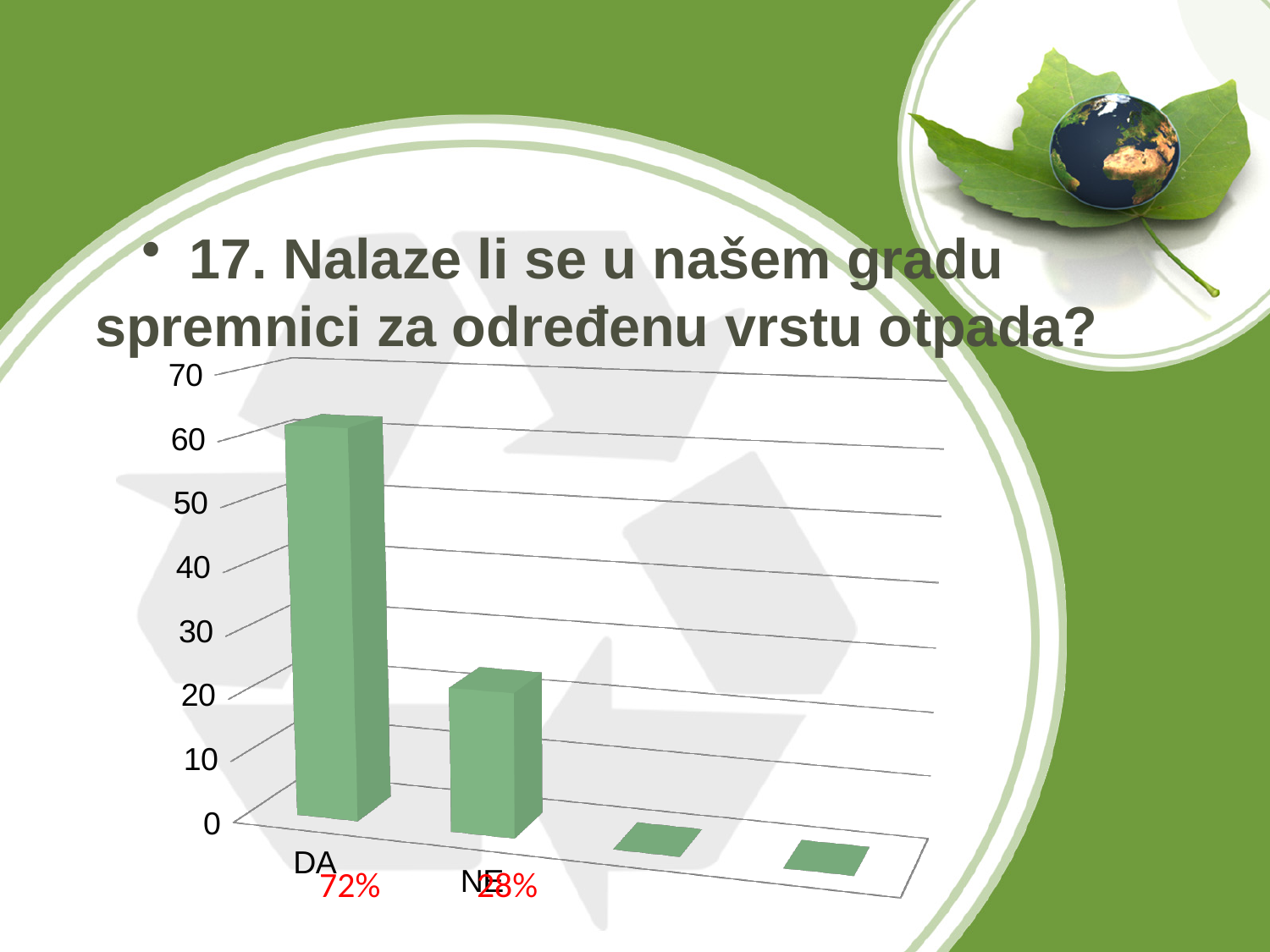
What is the highest value shown on the vertical axis? 70 What percentage is printed in red under the NE bar? 28% Is the bar for DA taller or shorter than the bar for NE? taller What percentage is printed in red under the DA bar? 72% Is the value for DA greater or less than 50? greater What question number is given in the slide title above the chart? 17 What kind of chart is shown on the slide? bar chart Which of the two labeled categories has the shorter bar? NE Is the value for NE greater or less than 10? greater Is the value for DA greater or less than 70? less Which category has the tallest bar, DA or NE? DA